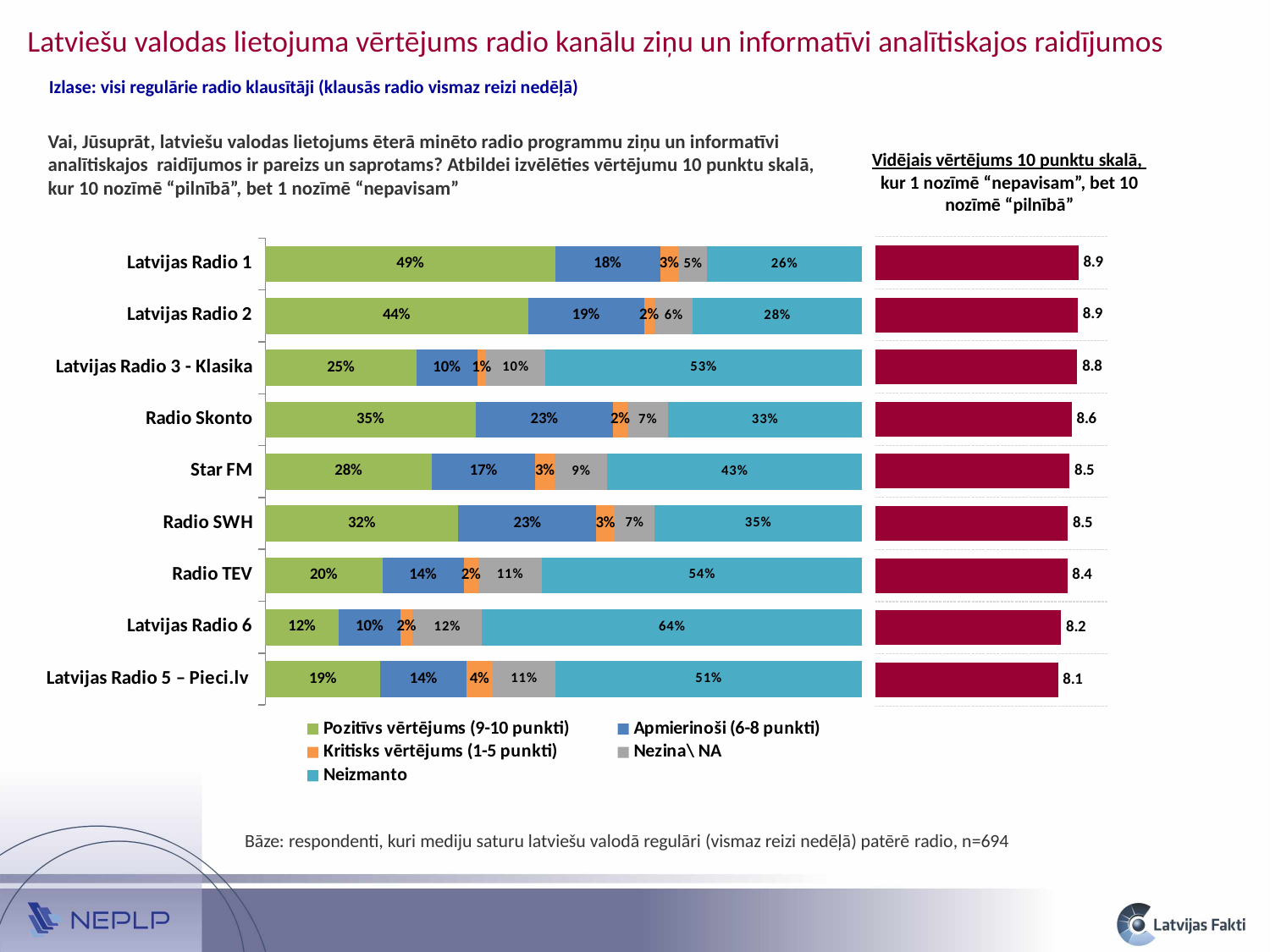
How many radio stations are shown in the stacked bar chart on the left? 9 What type of chart is the chart on the right titled 'Vidējais vērtējums 10 punktu skalā'? Bar chart In the stacked bar chart on the left, what is the 'Neizmanto' value for Latvijas Radio 6? 64% In the chart on the right titled 'Vidējais vērtējums 10 punktu skalā', what is the average rating for Radio SWH? 8.5 How many series does the legend of the stacked bar chart on the left list? 5 In the stacked bar chart on the left, what is the difference between the 'Neizmanto' values for Radio TEV and Star FM? 11% In the stacked bar chart on the left, what is the 'Apmierinoši (6-8 punkti)' value for Radio Skonto? 23% In the chart on the right titled 'Vidējais vērtējums 10 punktu skalā', which station has the lowest average rating? Latvijas Radio 5 – Pieci.lv In the stacked bar chart on the left, which station has the lowest 'Pozitīvs vērtējums (9-10 punkti)' value? Latvijas Radio 6 In the stacked bar chart on the left, what is the 'Pozitīvs vērtējums (9-10 punkti)' value for Latvijas Radio 1? 49% In the stacked bar chart on the left, which is larger: the 'Nezina\ NA' value for Latvijas Radio 6 or for Latvijas Radio 2? Latvijas Radio 6 In the stacked bar chart on the left, which station has the highest 'Pozitīvs vērtējums (9-10 punkti)' value? Latvijas Radio 1